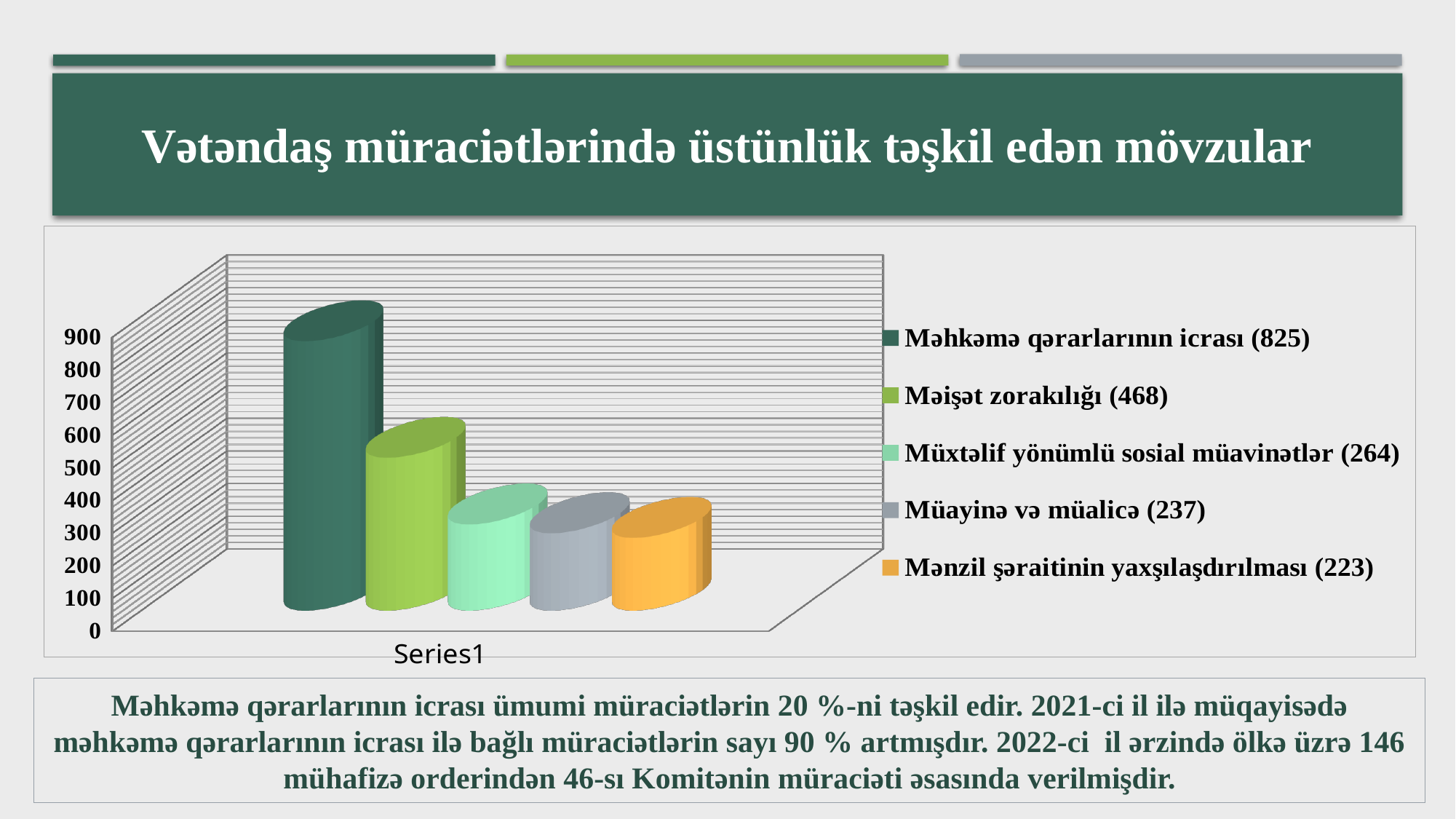
What is the title of the slide above the chart? Vətəndaş müraciətlərində üstünlük təşkil edən mövzular What value is shown for Müxtəlif yönümlü sosial müavinətlər? 264 Which topic has the highest value? Məhkəmə qərarlarının icrası What value is shown for Məişət zorakılığı? 468 What kind of chart is shown on the slide? bar chart What is the difference between the values for Məhkəmə qərarlarının icrası and Məişət zorakılığı? 357 Which is larger, the value for Müayinə və müalicə or the value for Mənzil şəraitinin yaxşılaşdırılması? Müayinə və müalicə Which topic has the lowest value? Mənzil şəraitinin yaxşılaşdırılması How many series does the legend list? 5 What value is shown for Məhkəmə qərarlarının icrası? 825 Is the value for Məişət zorakılığı greater or less than 500? less What value is shown for Mənzil şəraitinin yaxşılaşdırılması? 223